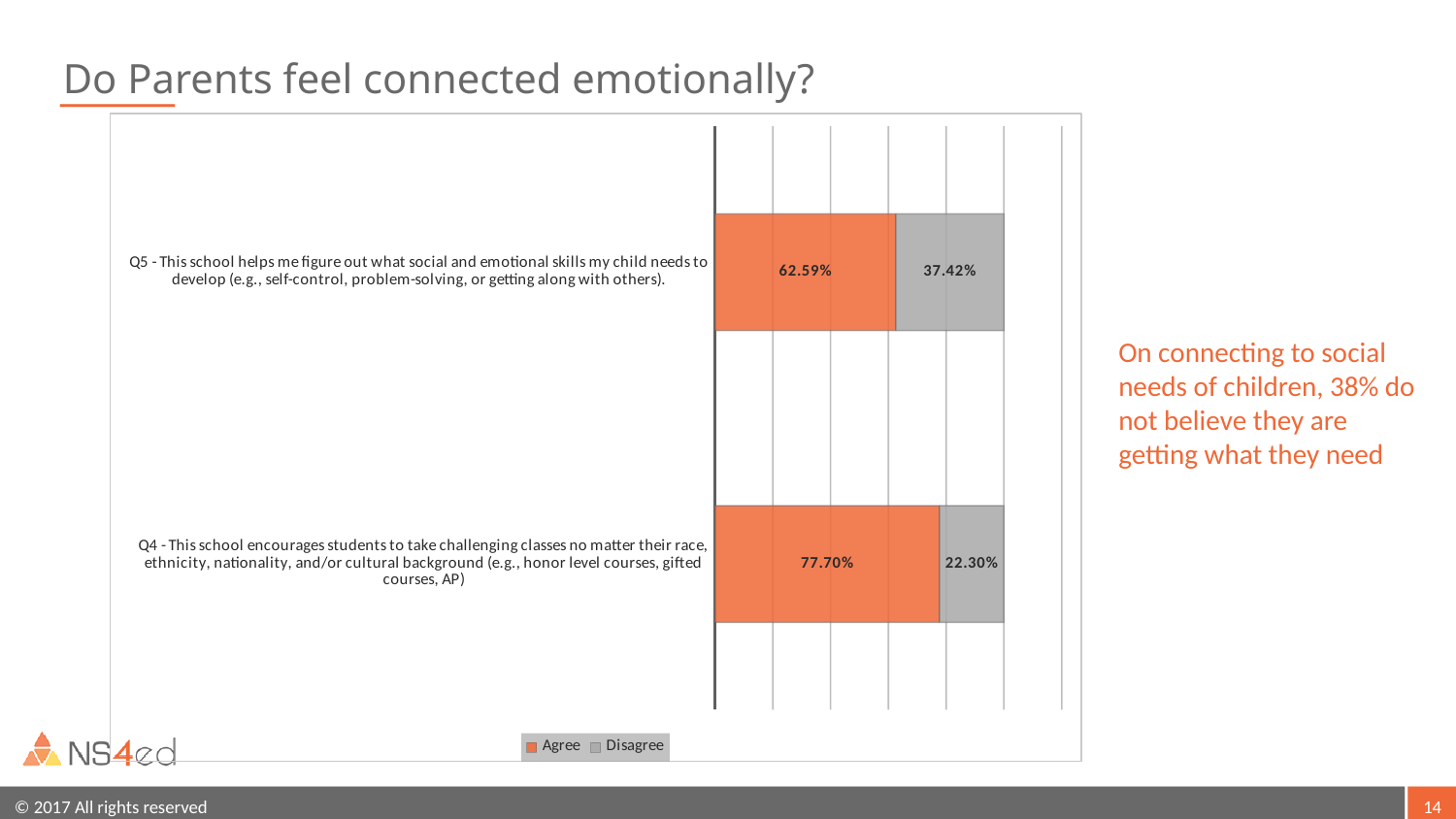
What is the difference between the Agree values for Q4 and Q5? 15.11% Which question has the higher Agree value, Q4 or Q5? Q4 How many categories (questions) are plotted in the chart? 2 What is the difference between the Agree and Disagree values for Q5? 25.17% How many series does the legend list? 2 Which colour represents Agree in the chart? Orange What is the Agree value for Q4? 77.70% What is the Disagree value for Q4? 22.30% What kind of chart is shown on the slide? Stacked bar chart What is the Agree value for Q5? 62.59% Which question has the lowest Disagree value? Q4 What is the Disagree value for Q5? 37.42%